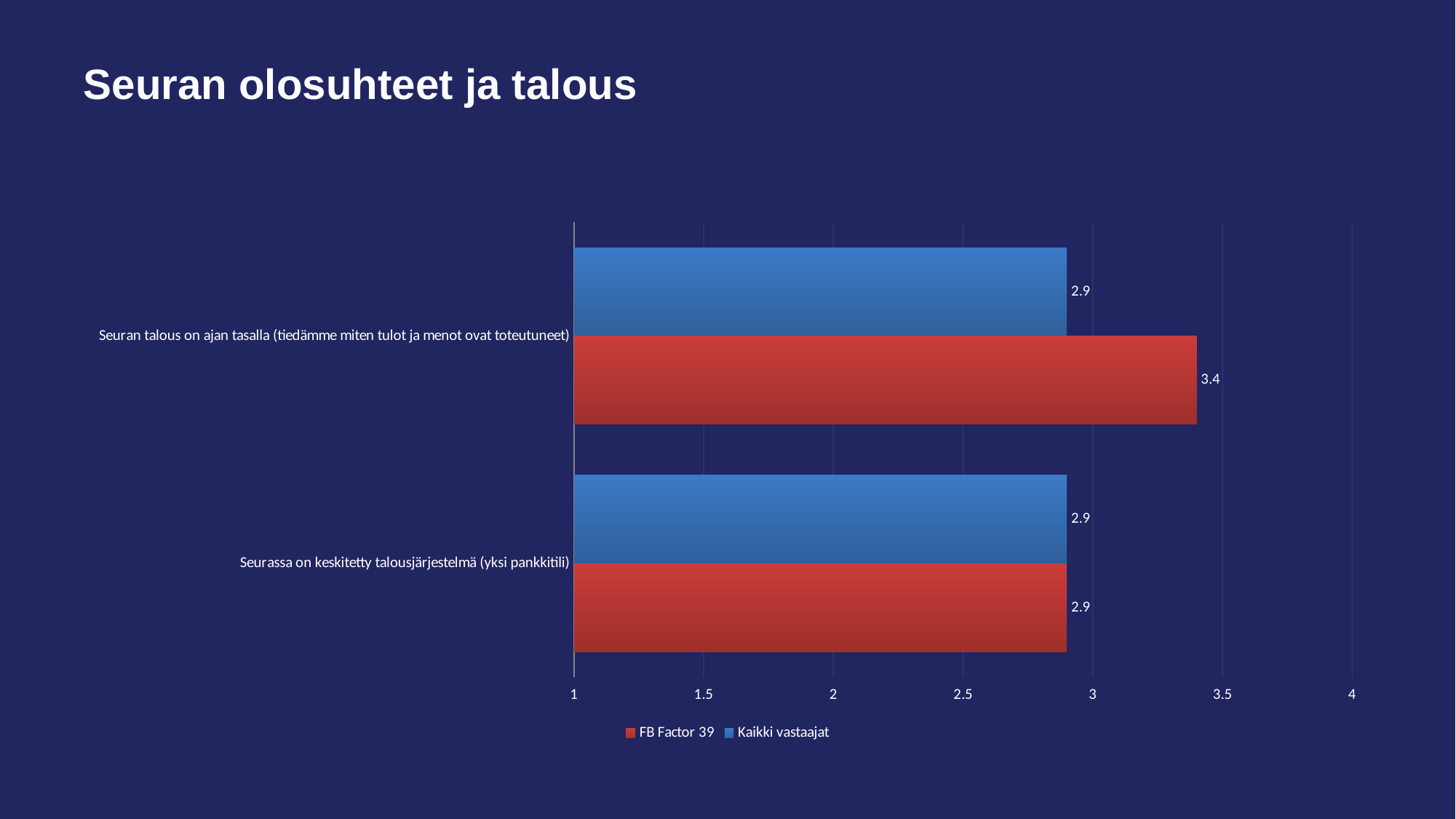
What is the value for Kaikki vastaajat on "Seuran talous on ajan tasalla (tiedämme miten tulot ja menot ovat toteutuneet)"? 2.9 What kind of chart is shown on the slide? Bar chart How many series does the legend list? 2 Which category has the highest value for FB Factor 39? Seuran talous on ajan tasalla (tiedämme miten tulot ja menot ovat toteutuneet) What is the value for Kaikki vastaajat on "Seurassa on keskitetty talousjärjestelmä (yksi pankkitili)"? 2.9 How many categories are shown on the chart? 2 What is the value for FB Factor 39 on "Seuran talous on ajan tasalla (tiedämme miten tulot ja menot ovat toteutuneet)"? 3.4 Which colour represents the FB Factor 39 series? Red Is the value for FB Factor 39 on "Seuran talous on ajan tasalla (tiedämme miten tulot ja menot ovat toteutuneet)" greater or less than 3? greater On "Seuran talous on ajan tasalla (tiedämme miten tulot ja menot ovat toteutuneet)", which series has the larger value, FB Factor 39 or Kaikki vastaajat? FB Factor 39 What is the difference between FB Factor 39 and Kaikki vastaajat on "Seuran talous on ajan tasalla (tiedämme miten tulot ja menot ovat toteutuneet)"? 0.5 What is the value for FB Factor 39 on "Seurassa on keskitetty talousjärjestelmä (yksi pankkitili)"? 2.9